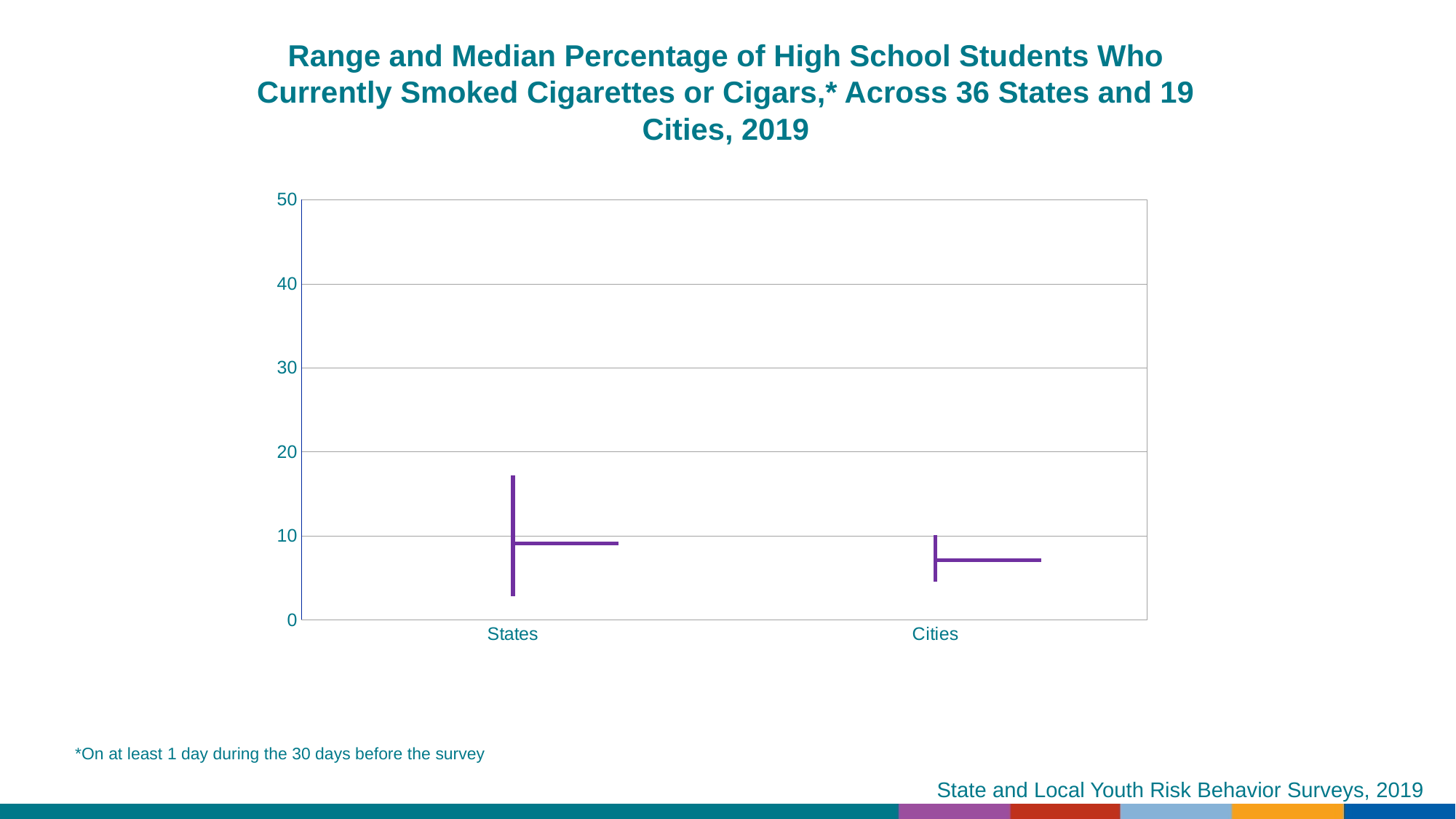
Which category has the lower minimum value, States or Cities? States What are the two categories shown on the x axis? States and Cities How many categories are shown on the x axis of the chart? 2 Is the maximum (top of the range) for States greater or less than 10? greater Is the minimum (bottom of the range) for States greater or less than 10? less Is the minimum (bottom of the range) for Cities greater or less than 10? less Which category has the higher maximum value, States or Cities? States What is the highest value shown on the y axis of the chart? 50 Which category has the wider range between its minimum and maximum, States or Cities? States